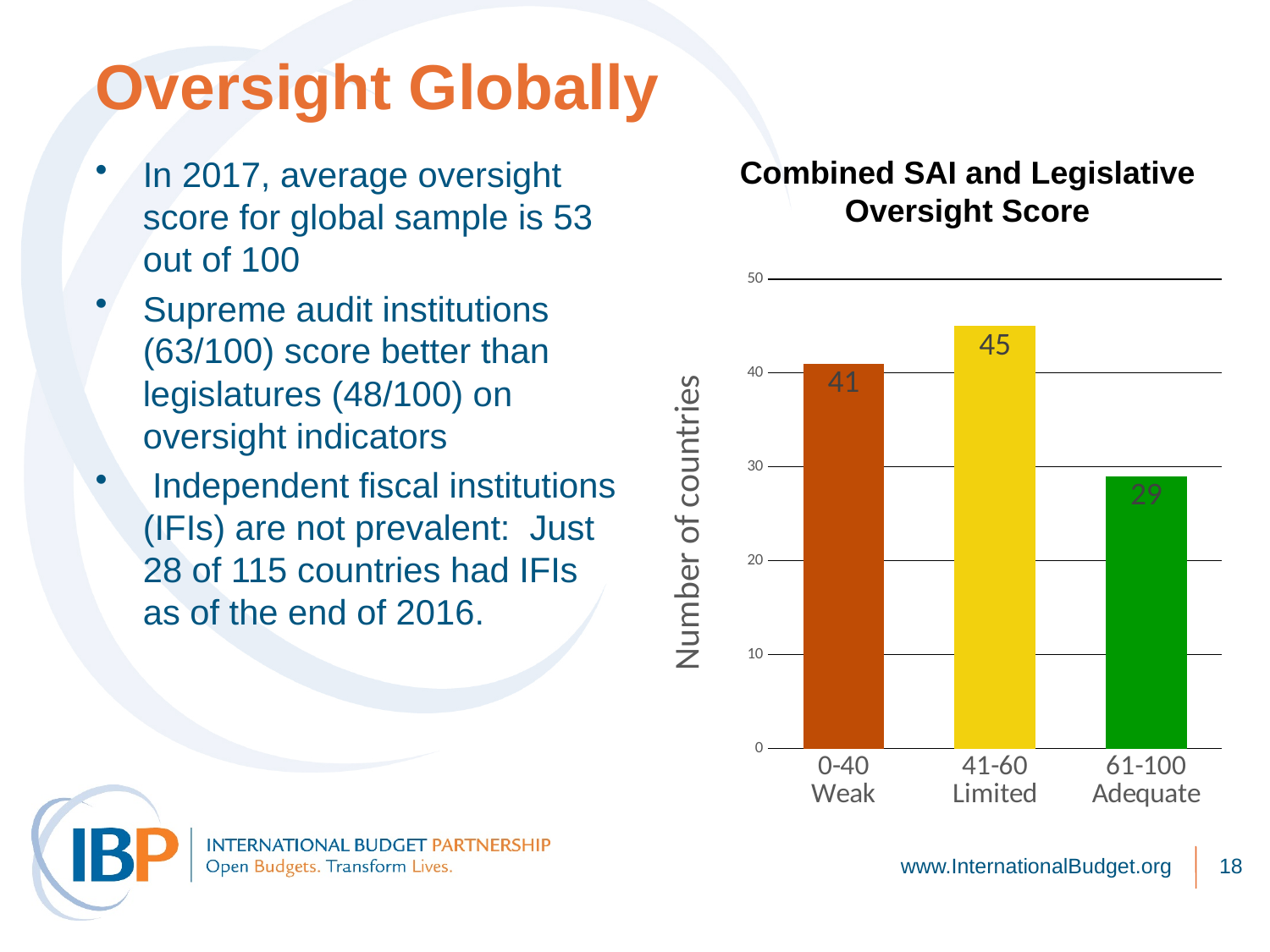
Which category has the highest number of countries? 41-60 Limited Is the value for 61-100 Adequate greater or less than 30? less What is the title of the chart? Combined SAI and Legislative Oversight Score Which category has the lowest number of countries? 61-100 Adequate What is the number of countries in the 61-100 Adequate category? 29 How many categories are shown in the chart? 3 What is the difference in the number of countries between the 41-60 Limited and 61-100 Adequate categories? 16 Which has more countries, the 0-40 Weak category or the 61-100 Adequate category? 0-40 Weak What kind of chart is shown on the slide? Bar chart What is the difference in the number of countries between the 41-60 Limited and 0-40 Weak categories? 4 What is the number of countries in the 41-60 Limited category? 45 What is the number of countries in the 0-40 Weak category? 41